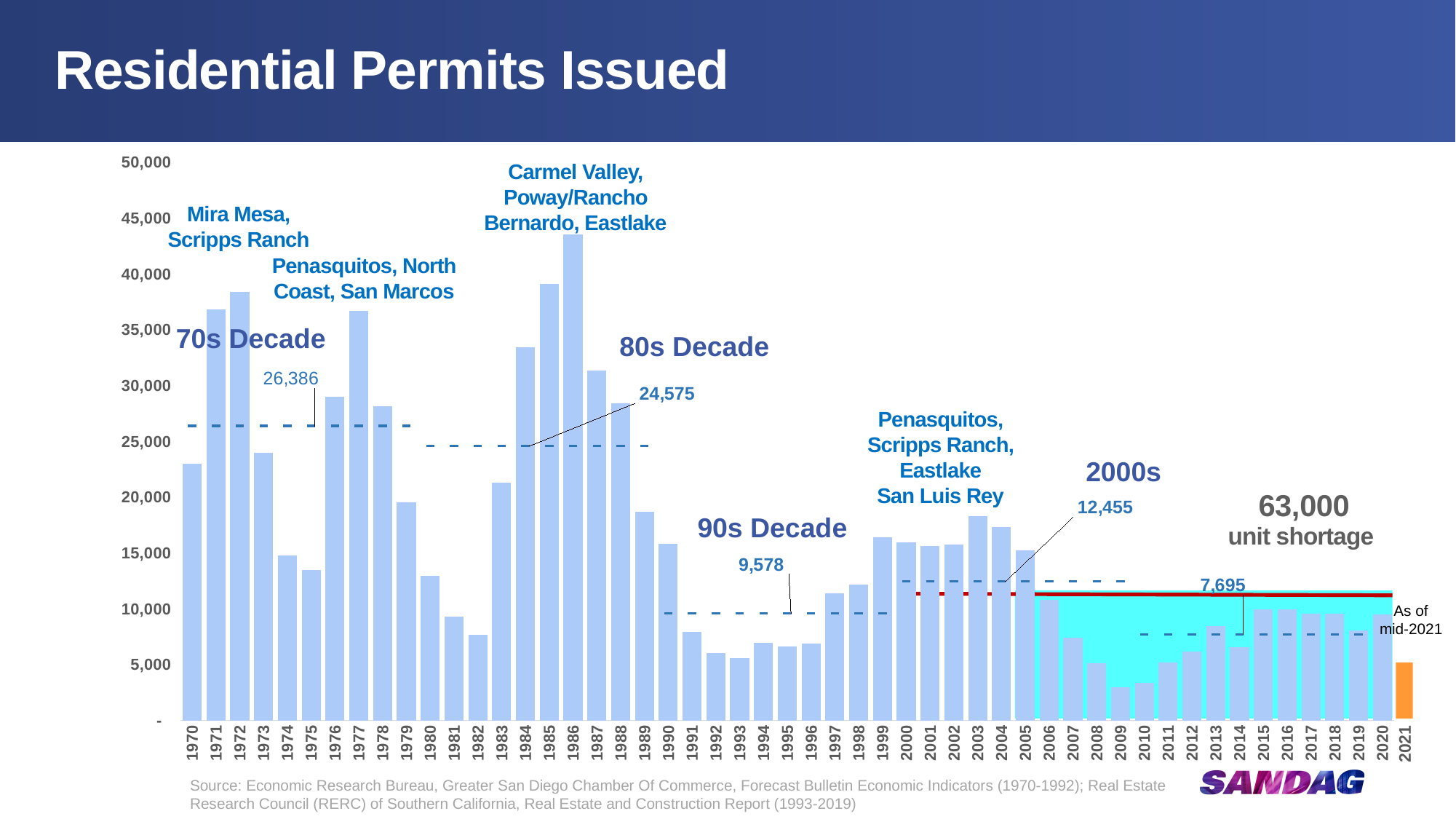
What type of chart is shown on the slide? bar chart What value is labeled for the 90s Decade dashed average line? 9,578 Which decade average is larger, the 2000s (12,455) or the 90s Decade (9,578)? 2000s What value is labeled for the 70s Decade dashed average line? 26,386 What unit shortage figure is stated on the chart? 63,000 Is the value for 2009 greater or less than 5,000? less What is the difference between the 70s Decade average (26,386) and the 80s Decade average (24,575)? 1,811 Which year has the shortest bar in the chart? 2009 What value is labeled for the 80s Decade dashed average line? 24,575 What value is labeled for the 2000s dashed average line? 12,455 Is the value for 1986 greater or less than 40,000? greater Which year has the tallest bar in the chart? 1986